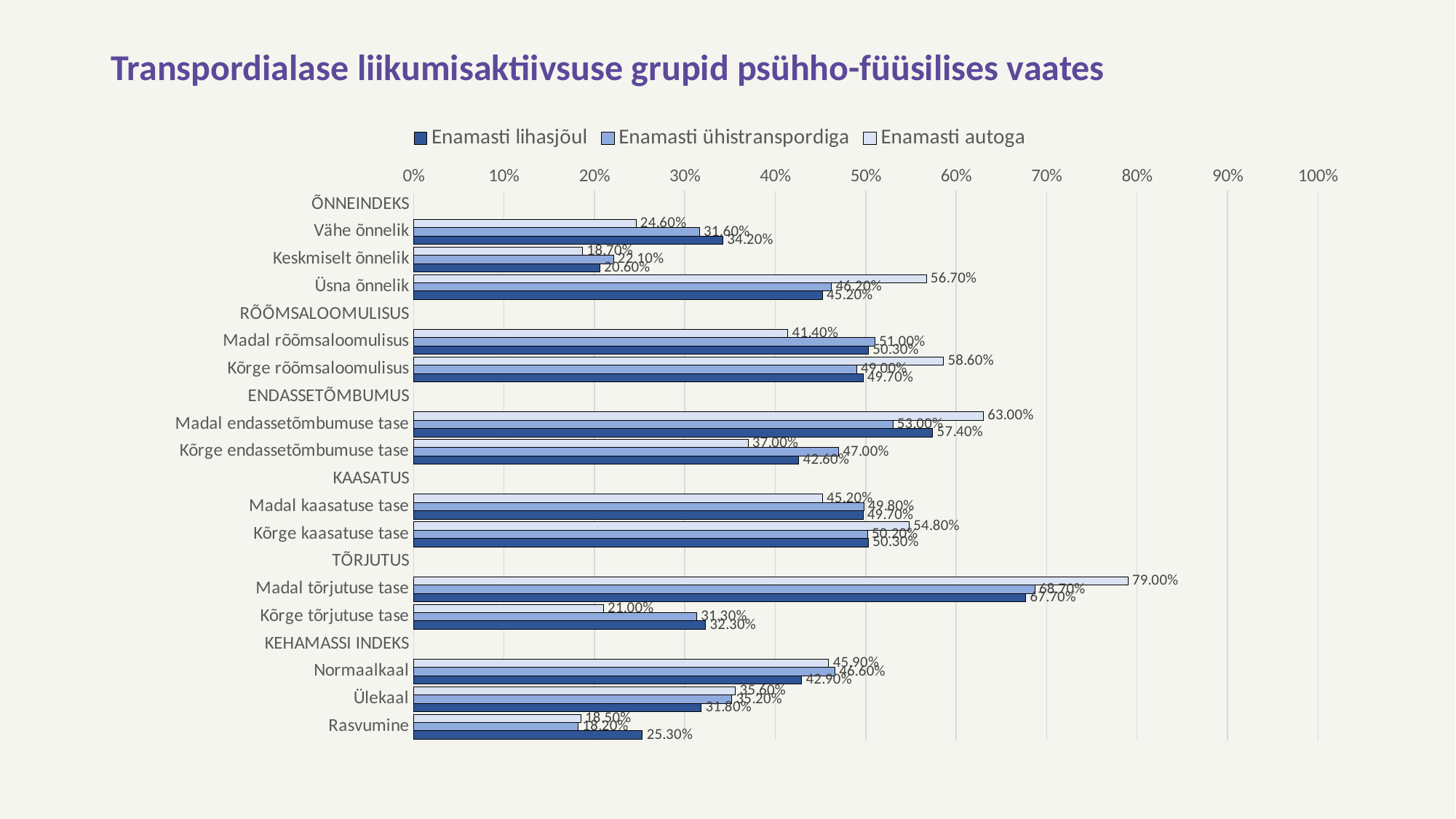
For Kõrge tõrjutuse tase, which is larger: the Enamasti autoga value or the Enamasti lihasjõul value? Enamasti lihasjõul Which category has the highest value in the Enamasti autoga series? Madal tõrjutuse tase What is the value for Rasvumine in the Enamasti lihasjõul series? 25.30% What is the title of the chart? Transpordialase liikumisaktiivsuse grupid psühho-füüsilises vaates What is the value for Madal tõrjutuse tase in the Enamasti autoga series? 79.00% What is the value for Üsna õnnelik in the Enamasti autoga series? 56.70% Is the Enamasti autoga value for Madal endassetõmbumuse tase greater or less than 60%? greater What kind of chart is shown on the slide? bar chart What is the difference between the Enamasti autoga and Enamasti lihasjõul values for Madal tõrjutuse tase? 11.30% Which category has the lowest value in the Enamasti lihasjõul series? Keskmiselt õnnelik How many series does the legend list? 3 What is the value for Keskmiselt õnnelik in the Enamasti ühistranspordiga series? 22.10%